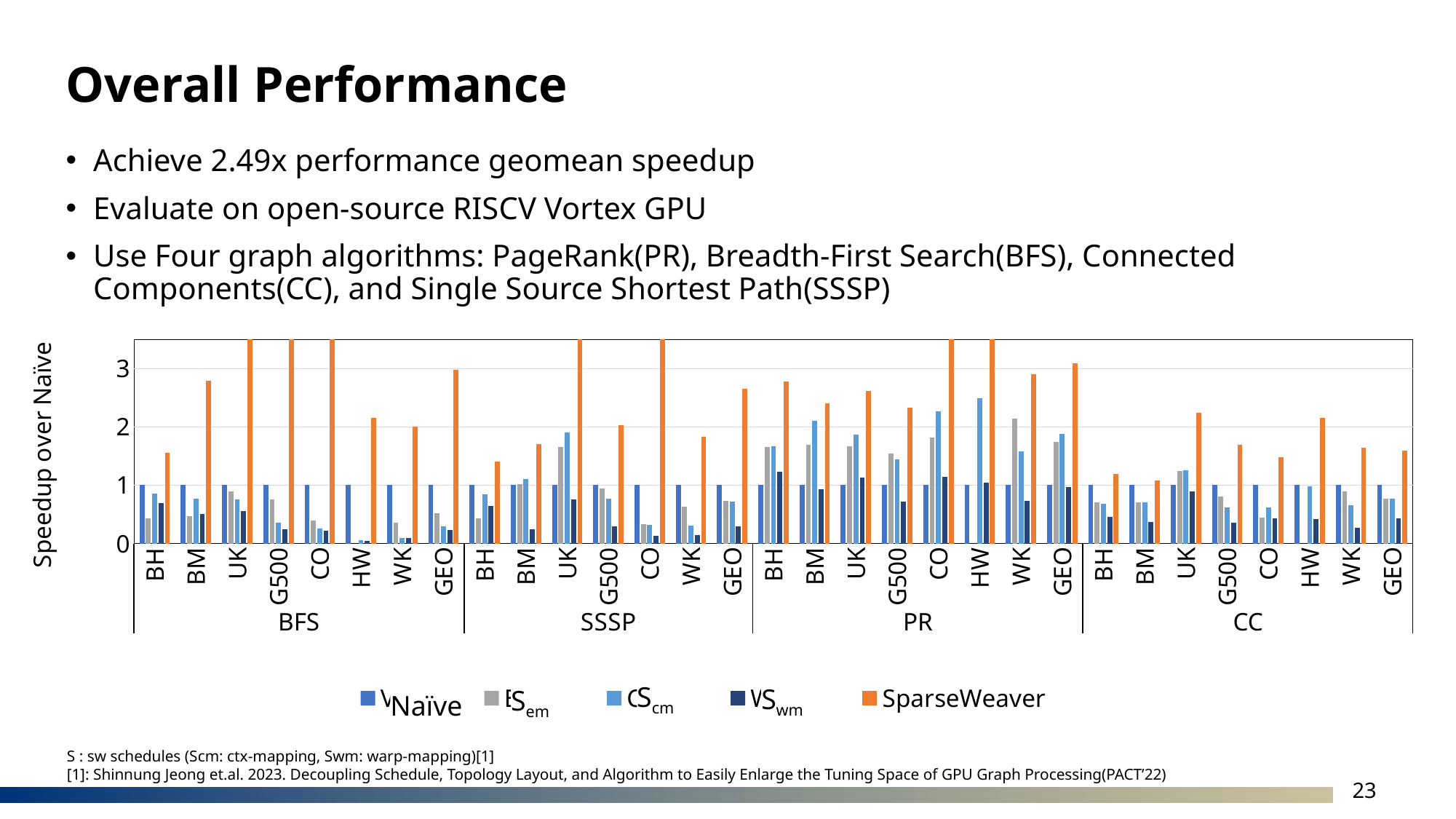
For HW in the PR group, which is larger: the SparseWeaver value or the S_cm value? SparseWeaver Within the BFS group, which category has the lowest SparseWeaver value? BH What is the y-axis title of the chart? Speedup over Naïve How many algorithm groups are shown along the x axis of the chart? 4 Is the SparseWeaver value for BH in the SSSP group greater or less than 2? less Is the S_wm value for HW in the BFS group greater or less than 1? less Is the SparseWeaver value for GEO in the PR group greater or less than 3? greater How many graph categories are shown within the BFS group? 8 What is the Naïve value for BH in the BFS group? 1 How many series does the chart legend list? 5 What kind of chart is shown on the slide? bar chart